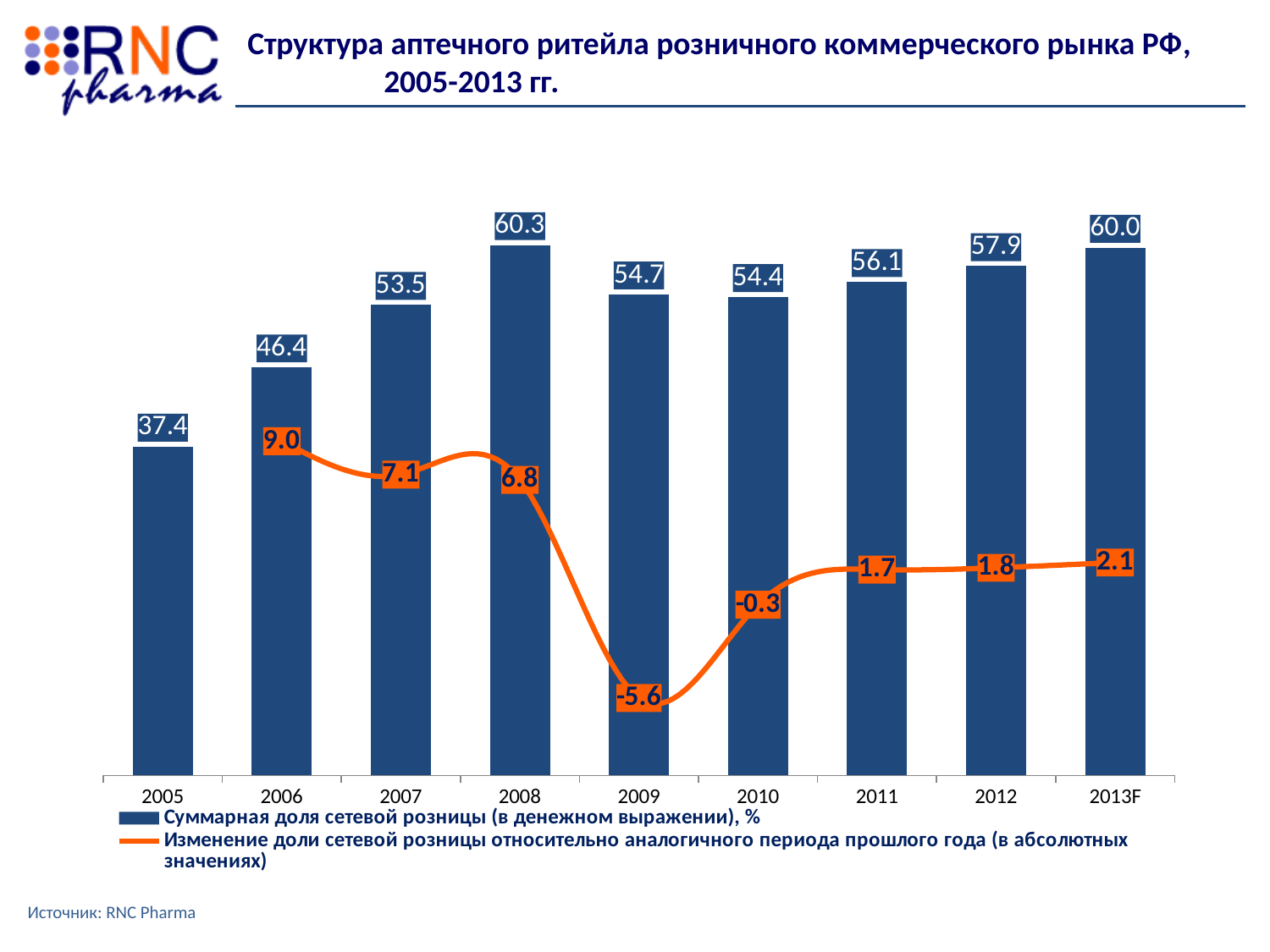
Which is larger, the bar value for 2012 or the bar value for 2011? 2012 What is the value of the orange line for 2009? -5.6 What is the value of the bar for 2008? 60.3 What is the value of the bar for 2005? 37.4 How many series does the legend list? 2 Which year has the lowest bar value? 2005 What kind of chart is shown on the slide? Combined bar and line chart How many years are shown on the x axis? 9 What is the value of the orange line for 2013F? 2.1 Which year has the lowest value on the orange line? 2009 What is the difference between the bar values for 2008 and 2009? 5.6 Which year has the highest bar value? 2008